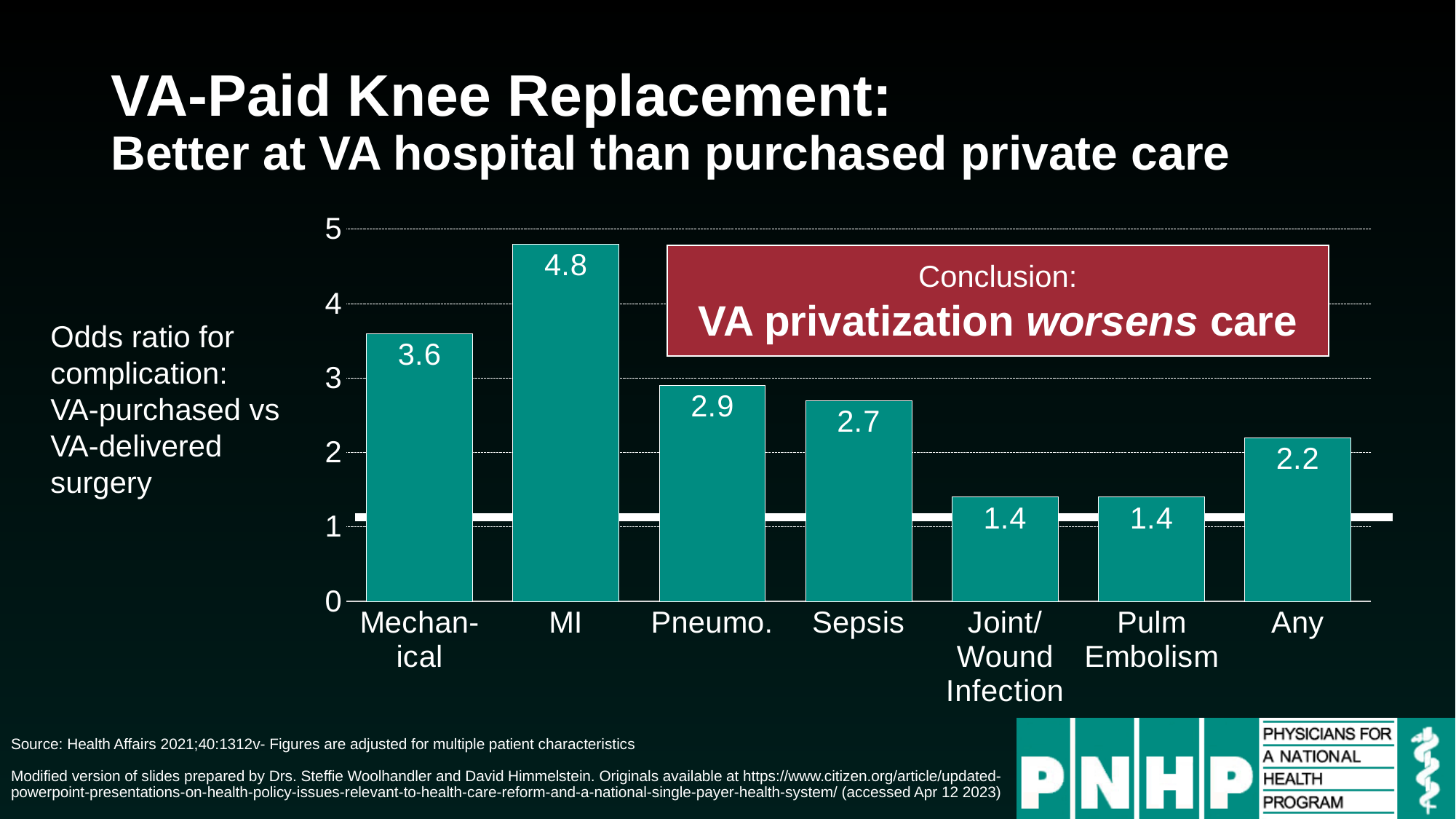
What is the difference between the odds ratio for MI and the odds ratio for Mechanical complications? 1.2 What is the odds ratio for Pulm Embolism? 1.4 Which has a larger odds ratio, Pneumo. or Sepsis? Pneumo. What kind of chart is shown on the slide? Bar chart What is the odds ratio for complication for Sepsis? 2.7 How many complication categories are shown on the chart? 7 Is the odds ratio for Any complication greater or less than 2? greater What is the odds ratio for complication for MI? 4.8 What is the odds ratio for complication for Any complication? 2.2 What is the difference between the odds ratio for Pneumo. and the odds ratio for Joint/Wound Infection? 1.5 Which complication category has the highest odds ratio? MI What conclusion is stated in the red box on the chart? VA privatization worsens care